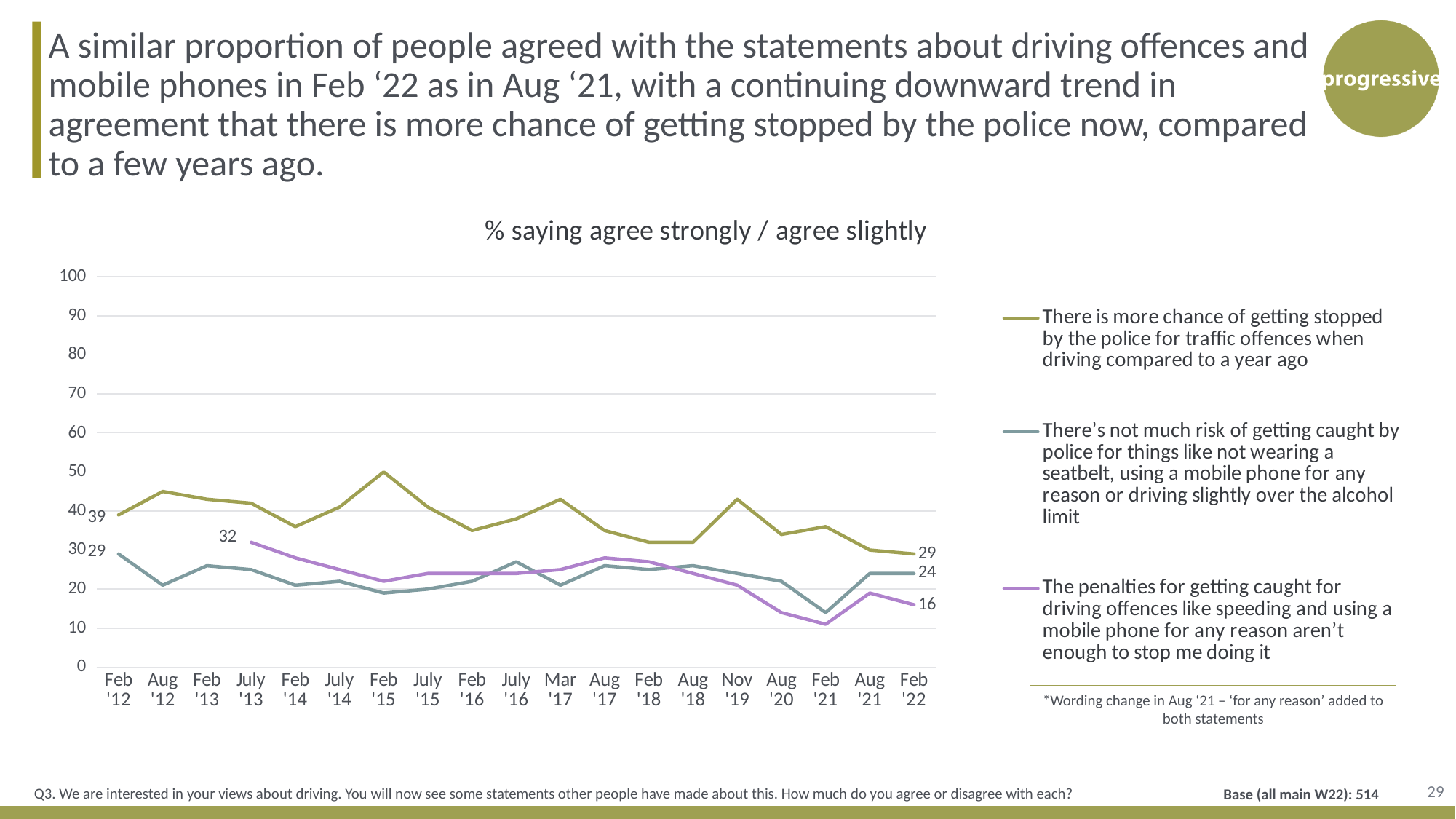
In Feb '22, which is larger: the value for 'There's not much risk of getting caught by police...' or the value for 'The penalties... aren't enough to stop me doing it'? There's not much risk of getting caught by police... By how much did 'There is more chance of getting stopped by the police...' fall between Feb '12 and Feb '22? 10 What is the value for 'There is more chance of getting stopped by the police for traffic offences when driving compared to a year ago' in Feb '22? 29 What is the title of the chart? % saying agree strongly / agree slightly What kind of chart is shown on the slide? Line chart At which time point does 'There is more chance of getting stopped by the police...' reach its highest value? Feb '15 What is the value for 'There is more chance of getting stopped by the police...' in Feb '12? 39 What is the value for 'There's not much risk of getting caught by police...' in Feb '12? 29 What is the first labelled value for 'The penalties for getting caught... aren't enough to stop me doing it', shown at July '13? 32 What is the value for 'The penalties for getting caught for driving offences... aren't enough to stop me doing it' in Feb '22? 16 How many series does the legend list? 3 Is the value for 'The penalties... aren't enough to stop me doing it' in Feb '21 greater or less than 20? less